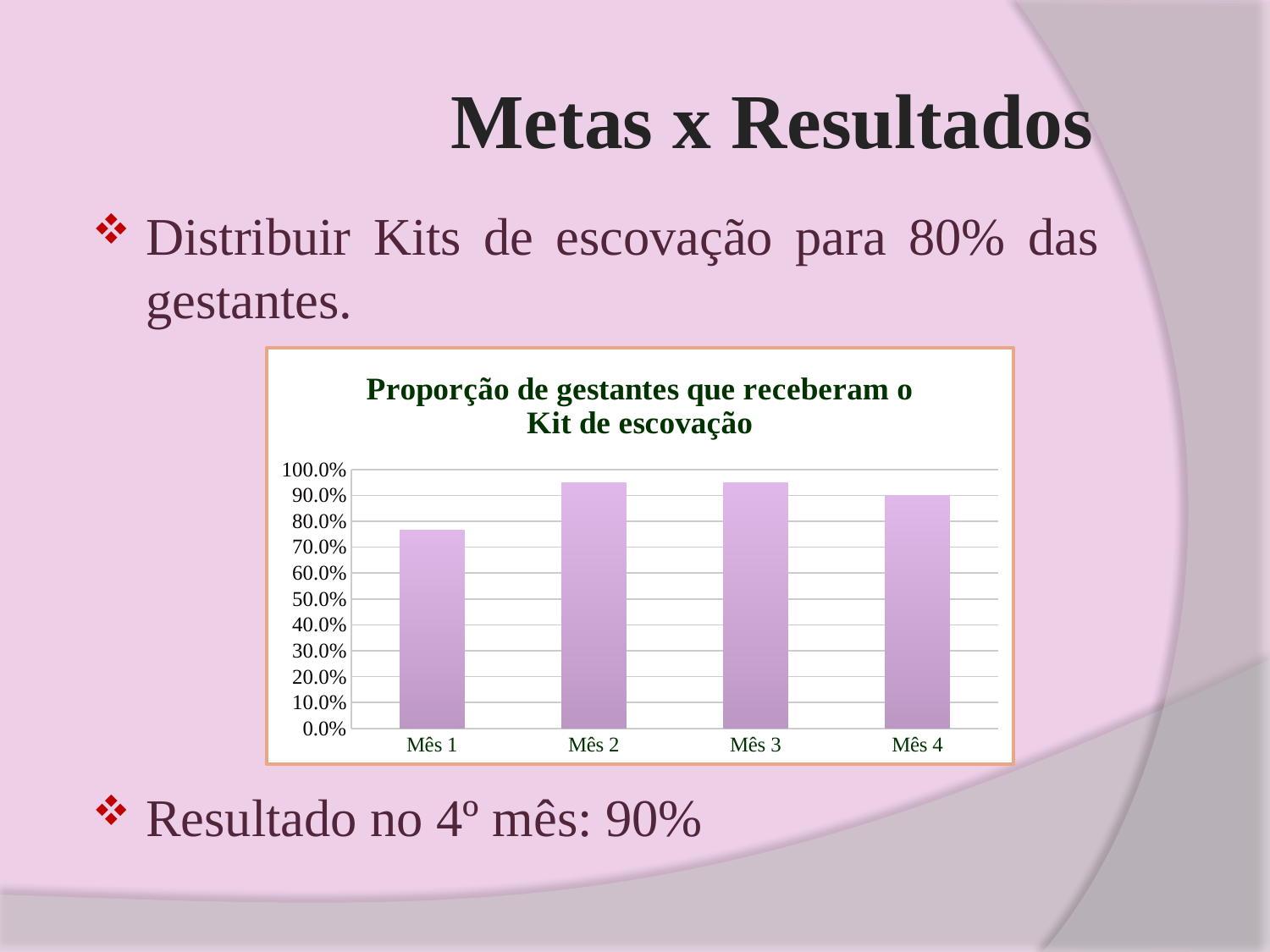
Which month has the lowest proportion in the chart? Mês 1 Which is larger, the value for Mês 4 or the value for Mês 1? Mês 4 Is the value for Mês 1 greater or less than 70.0%? greater Which is larger, the value for Mês 1 or the value for Mês 2? Mês 2 What kind of chart is shown on the slide? bar chart Is the value for Mês 1 greater or less than 80.0%? less Is the value for Mês 3 greater or less than 90.0%? greater What is the value for Mês 4 in the chart? 90.0% What is the title of the chart? Proporção de gestantes que receberam o Kit de escovação How many months (categories) are plotted in the chart? 4 Which is larger, the value for Mês 3 or the value for Mês 4? Mês 3